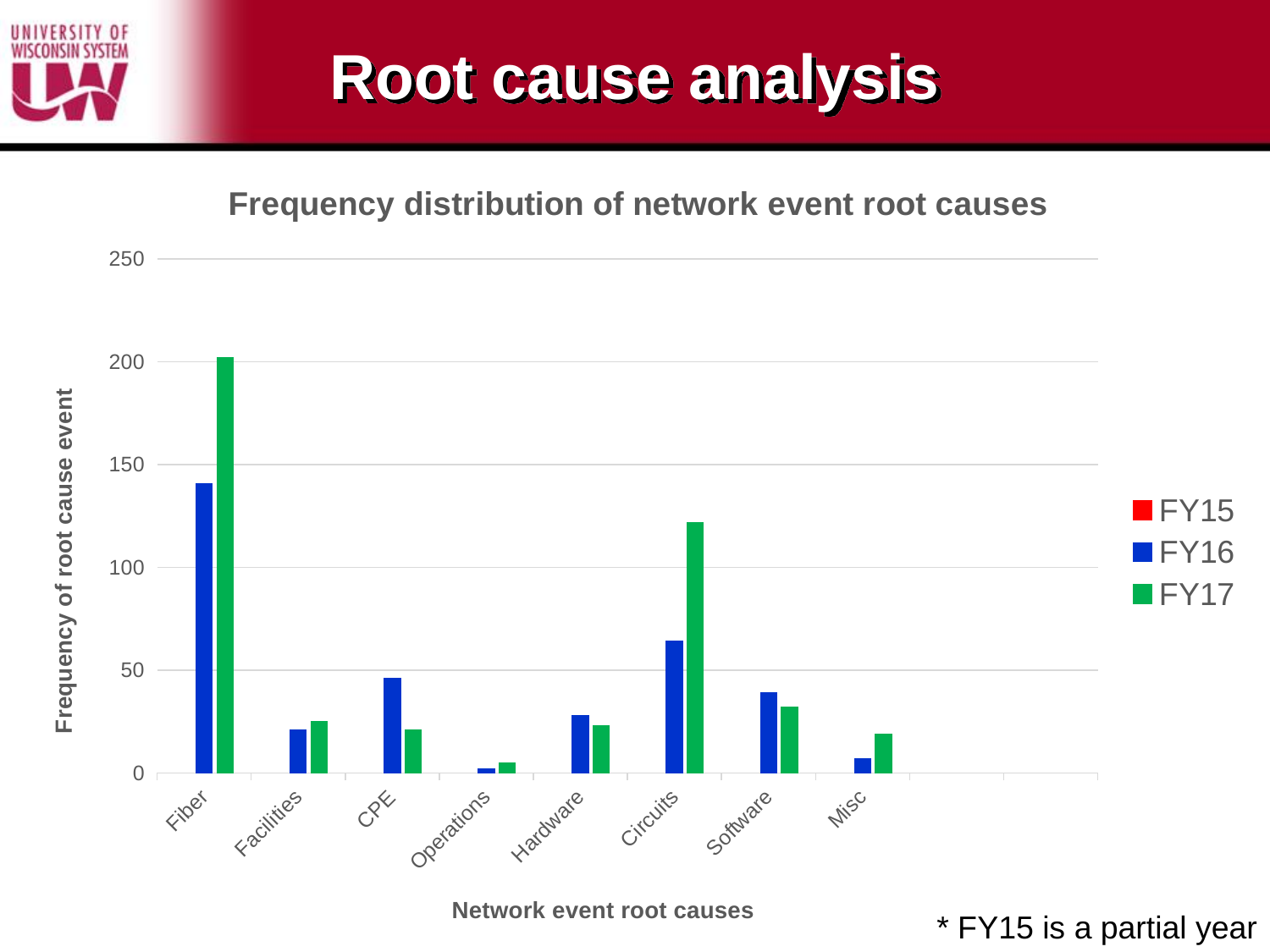
How many root cause categories are shown on the x axis? 8 Is the FY17 value for Circuits greater or less than 100? greater Which root cause category has the lowest FY17 frequency? Operations Is the FY17 value for Fiber greater or less than 150? greater Is the FY16 value for CPE greater or less than 50? less For Circuits, which series has the larger value, FY16 or FY17? FY17 For CPE, which series has the larger value, FY16 or FY17? FY16 How many series does the legend list? 3 Which root cause category has the highest FY17 frequency? Fiber What kind of chart is shown on the slide? Bar chart What is the title of the chart? Frequency distribution of network event root causes Which root cause category has the highest FY16 frequency? Fiber